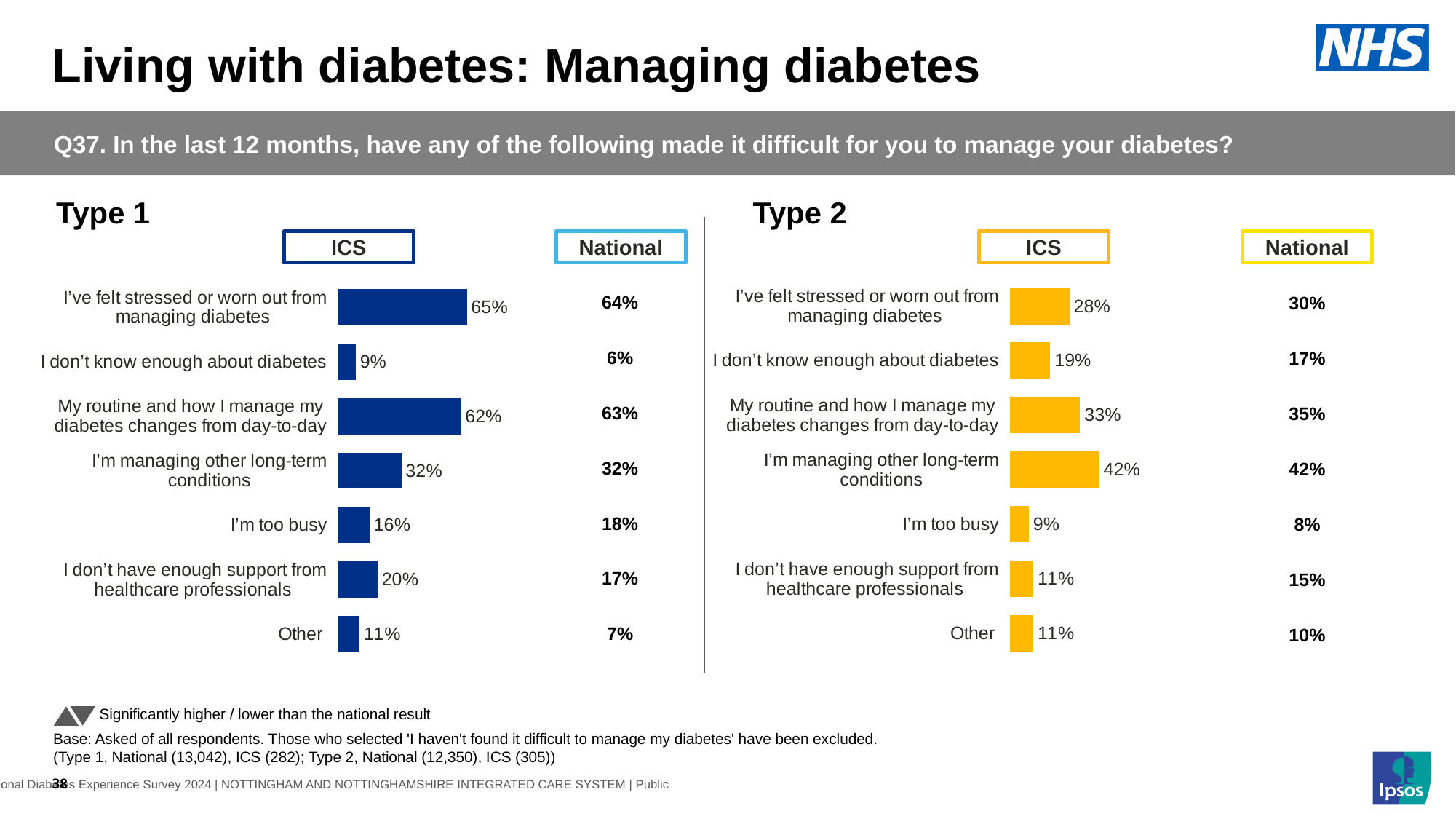
In the Type 1 chart, what is the ICS value for 'I've felt stressed or worn out from managing diabetes'? 65% What kind of chart is used for the Type 1 ICS results? Bar chart In the Type 2 chart, what is the difference between the National and ICS values for 'I don't know enough about diabetes'? 2% In the Type 1 chart, what is the difference between the ICS and National values for 'I don't have enough support from healthcare professionals'? 3% In the Type 2 chart, which category has the highest ICS value? I'm managing other long-term conditions In the Type 1 chart, which category has the lowest ICS value? I don't know enough about diabetes What colour are the ICS bars in the Type 2 chart? Yellow In the Type 1 chart, how many categories are shown? 7 In the Type 2 chart, which is larger for 'I'm too busy': the ICS value or the National value? ICS In the Type 2 chart, what is the ICS value for 'I'm managing other long-term conditions'? 42% In the Type 2 chart, what is the National value for 'Other'? 10% In the Type 1 chart, what is the National value for 'I don't know enough about diabetes'? 6%